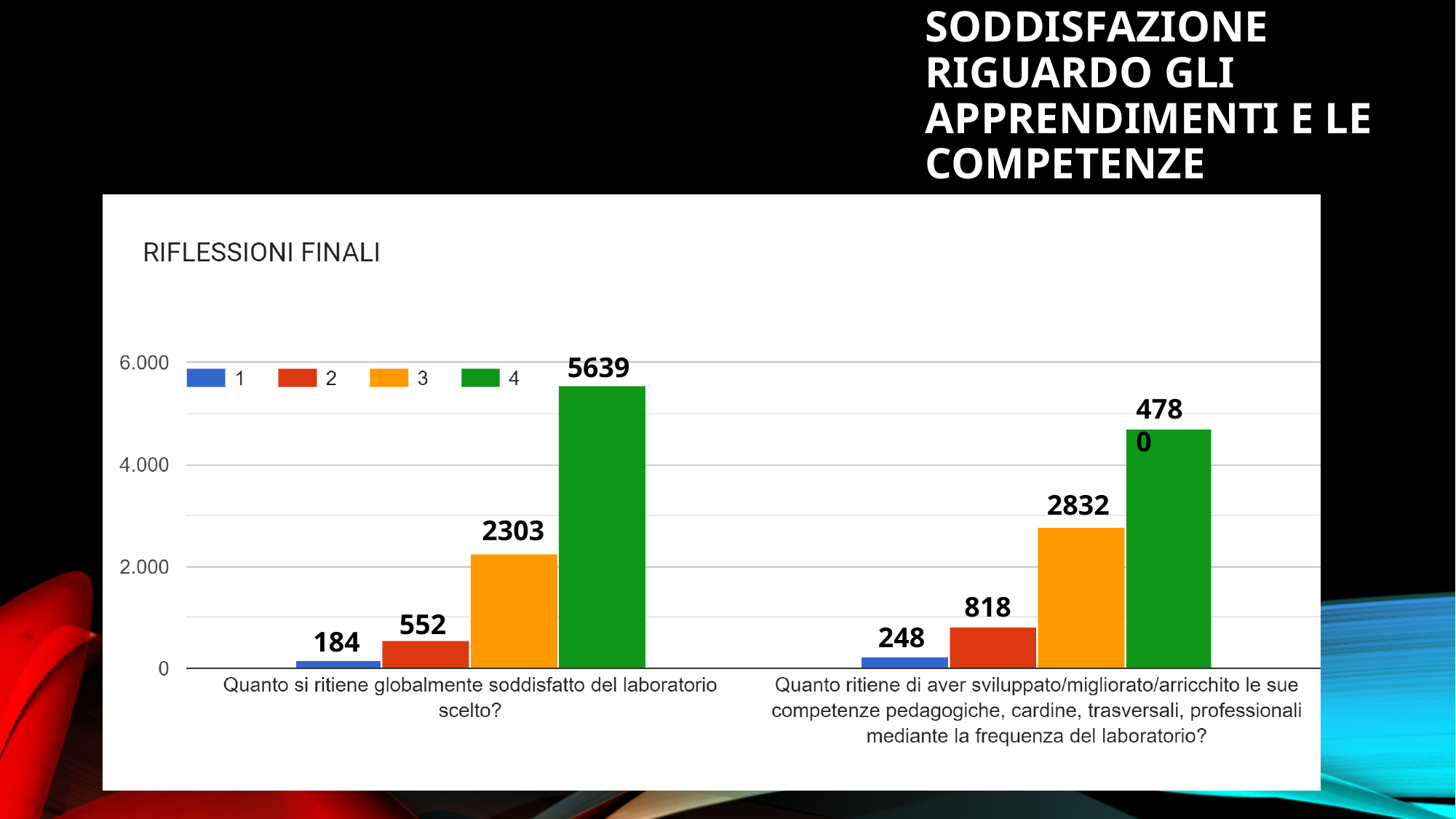
Which series has the highest value for the question "Quanto si ritiene globalmente soddisfatto del laboratorio scelto?"? 4 How many series does the legend list? 4 Which is larger: the series 4 value for the first question or the series 4 value for the second question? the first question (5639) What kind of chart is shown on the slide? bar chart Which series has the lowest value for the question about developing competenze pedagogiche, cardine, trasversali, professionali? 1 What is the value for series 3 for the question about developing competenze pedagogiche, cardine, trasversali, professionali? 2832 What is the difference between the series 3 value and the series 2 value for the question "Quanto si ritiene globalmente soddisfatto del laboratorio scelto?"? 1751 What is the value for series 1 for the question "Quanto si ritiene globalmente soddisfatto del laboratorio scelto?"? 184 What is the value for series 4 for the question "Quanto si ritiene globalmente soddisfatto del laboratorio scelto?"? 5639 What is the title of the chart? RIFLESSIONI FINALI How many question categories are shown on the x axis? 2 What is the value for series 2 for the question about developing competenze pedagogiche, cardine, trasversali, professionali? 818